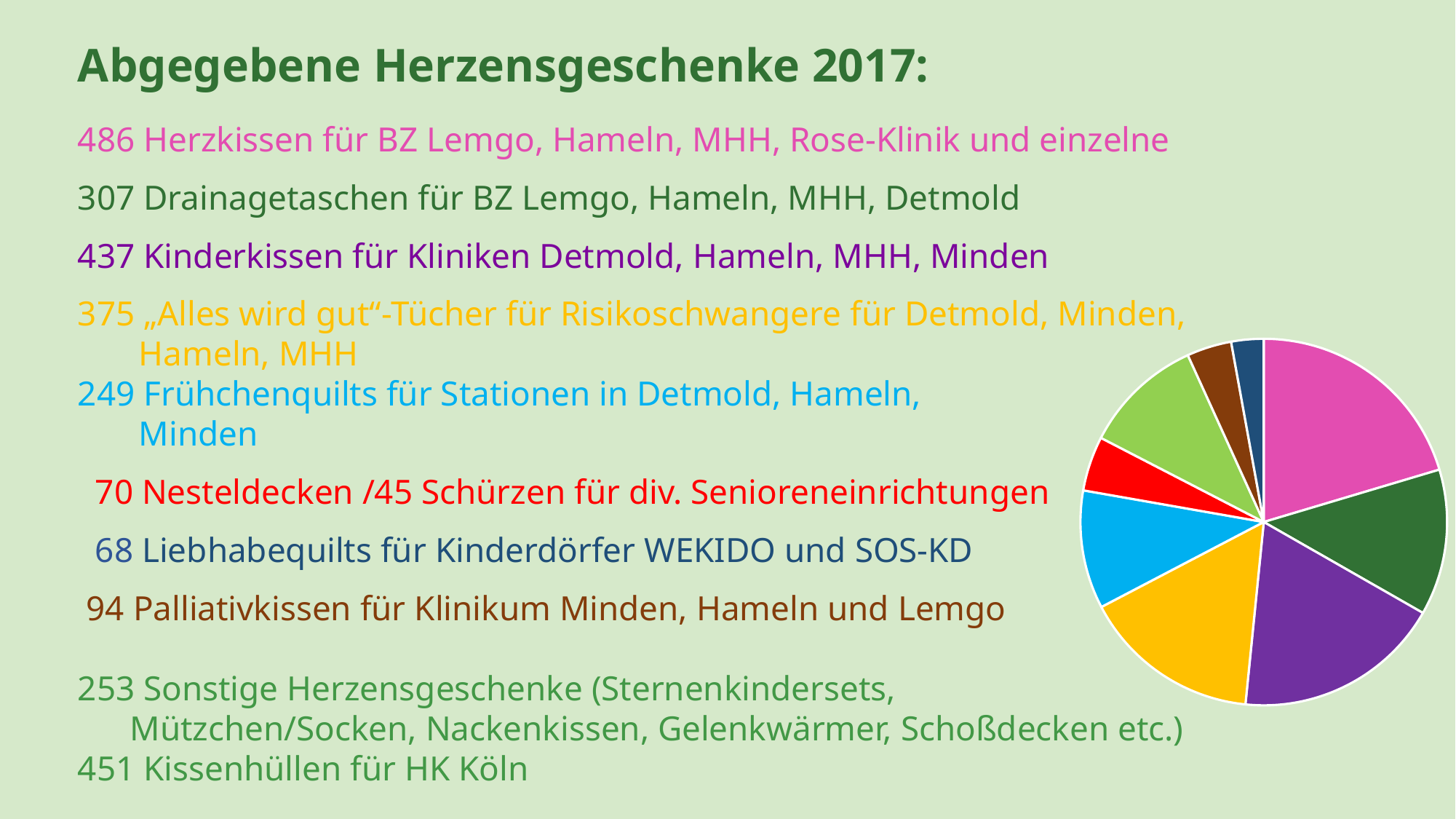
In the pie chart, which slice is larger, the brown one or the light green one? light green In the pie chart, which slice is larger, the pink one or the dark green one? pink In the pie chart, which slice is larger, the light blue one or the red one? light blue How many slices does the pie chart have? 9 Which colour slice is the largest in the pie chart? pink Which colour slice is the smallest in the pie chart? dark blue What kind of chart is shown on the right side of the slide? pie chart Does the pie chart show data labels on its slices? No Does the pie chart display a legend? No